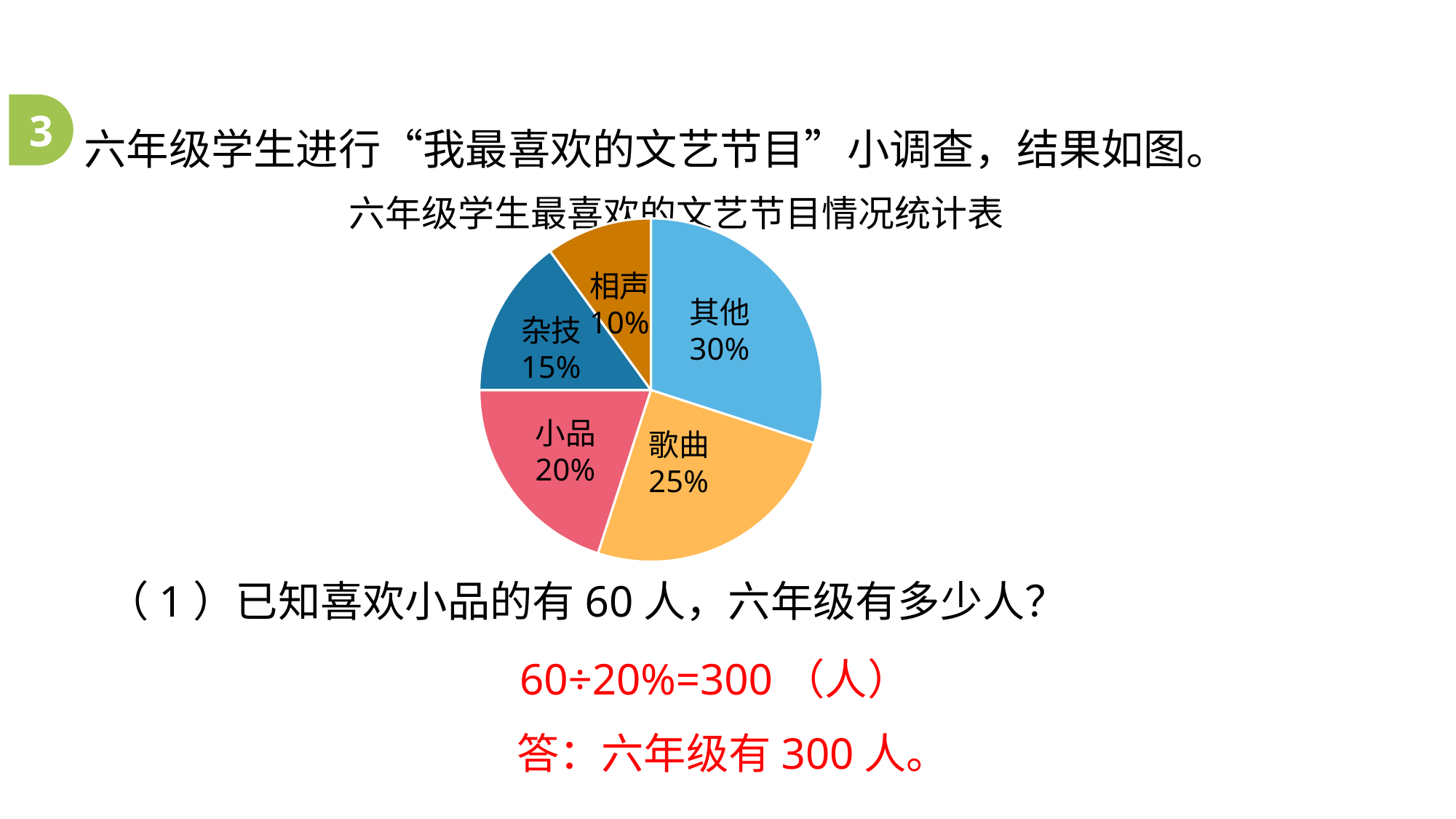
What percentage of the pie chart is 杂技? 15% What percentage of the pie chart is 其他? 30% Which category has the smallest share of the pie chart? 相声 What is the difference in percentage points between 歌曲 and 杂技? 10% How many categories are shown in the pie chart? 5 What is the title of the pie chart? 六年级学生最喜欢的文艺节目情况统计表 What percentage of the pie chart is 相声? 10% Which category has the largest share of the pie chart? 其他 What percentage of the pie chart is 小品? 20% Which has a larger share, 小品 or 歌曲? 歌曲 What percentage of the pie chart is 歌曲? 25% What kind of chart is shown on the slide? pie chart